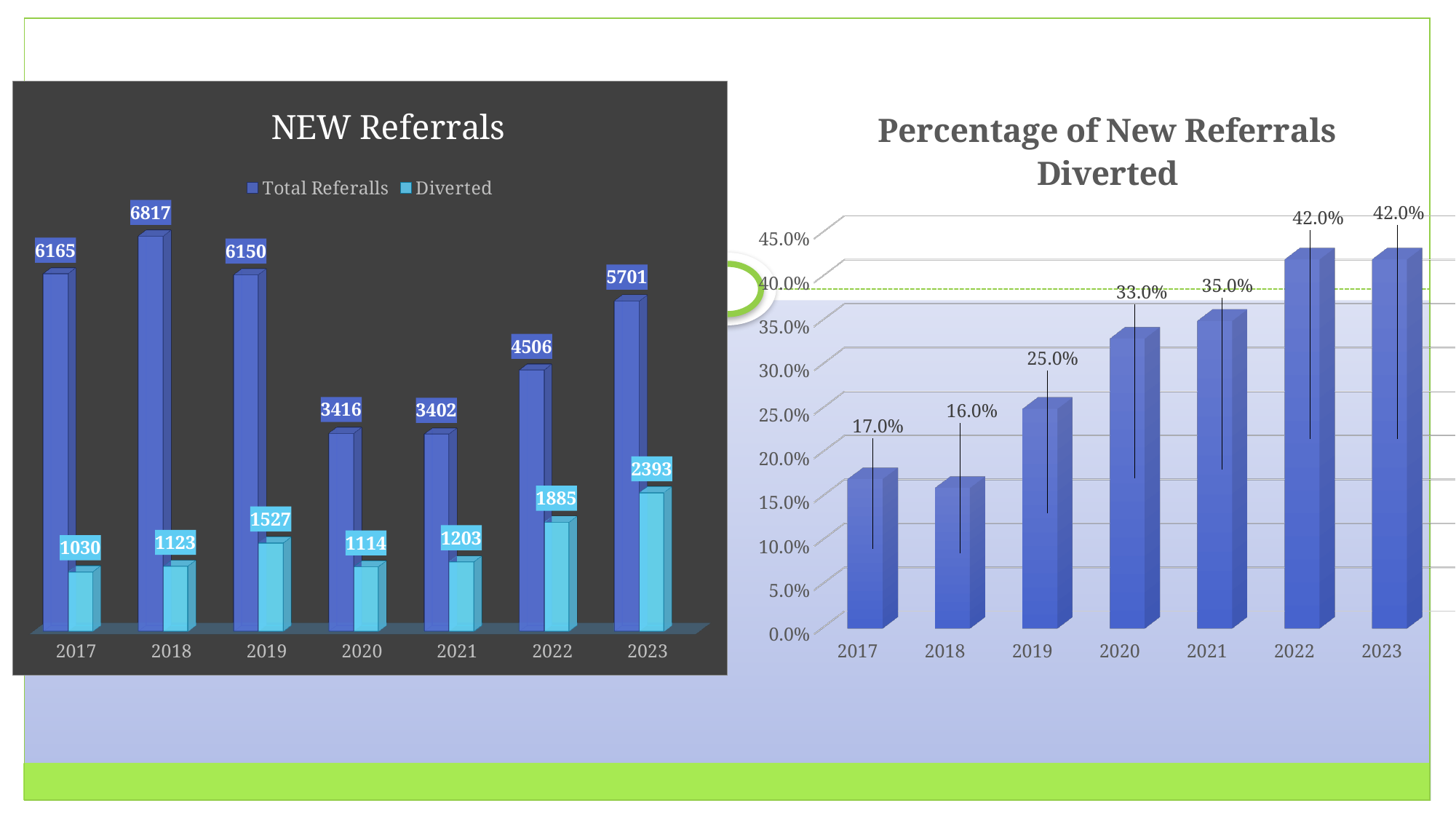
In the NEW Referrals chart, what is the value of Total Referalls for 2018? 6817 In the NEW Referrals chart, how many years are shown on the x axis? 7 In the NEW Referrals chart, what is the difference between Total Referalls and Diverted in 2022? 2621 In the NEW Referrals chart, what is the Diverted value for 2023? 2393 In the NEW Referrals chart, which year has the highest Total Referalls value? 2018 In the Percentage of New Referrals Diverted chart, what is the value for 2019? 25.0% In the Percentage of New Referrals Diverted chart, is the value for 2020 larger than the value for 2017? Yes In the NEW Referrals chart, how many series does the legend list? 2 In the Percentage of New Referrals Diverted chart, what is the difference between the 2021 and 2018 values? 19.0% What kind of chart is the Percentage of New Referrals Diverted chart? Bar chart In the NEW Referrals chart, which year has the lowest Diverted value? 2017 In the Percentage of New Referrals Diverted chart, which year has the lowest value? 2018